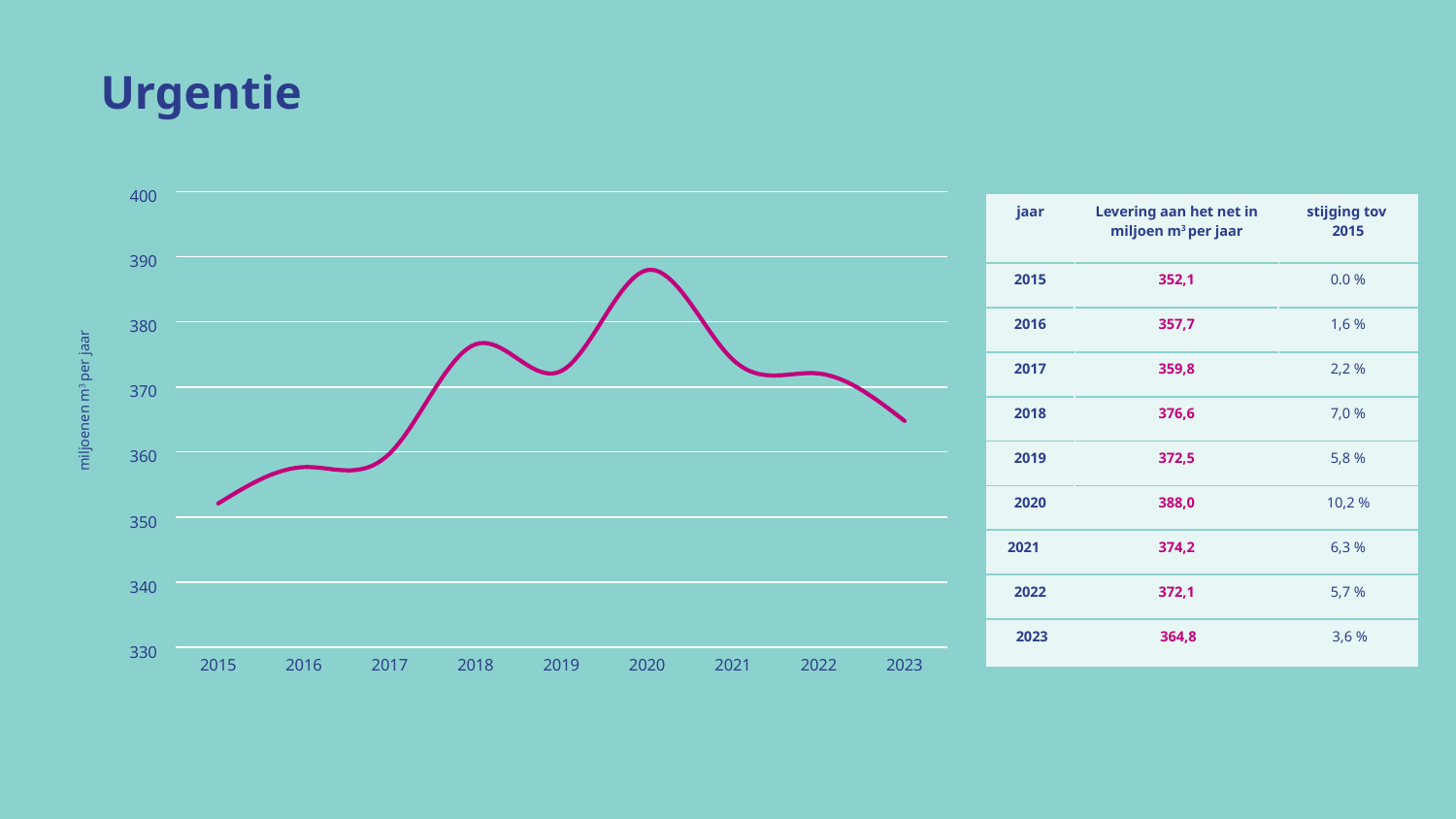
Is the value for 2023 on the line chart greater or less than 360? greater According to the table, what was the delivery to the network in 2015 (in million m³ per year)? 352,1 Which year has the lowest value on the line chart? 2015 Which year has the larger value, 2018 or 2019? 2018 What kind of chart is shown on the slide? line chart What is the label on the y axis of the line chart? miljoenen m³ per jaar Which year has the highest value on the line chart? 2020 What is the 'stijging tov 2015' percentage shown in the table for 2020? 10,2 % Is the value for 2016 on the line chart greater or less than 360? less According to the table, what was the delivery to the network in 2020 (in million m³ per year)? 388,0 What is the difference between the 2020 value and the 2015 value in the table? 35,9 How many years are plotted along the x axis of the line chart? 9